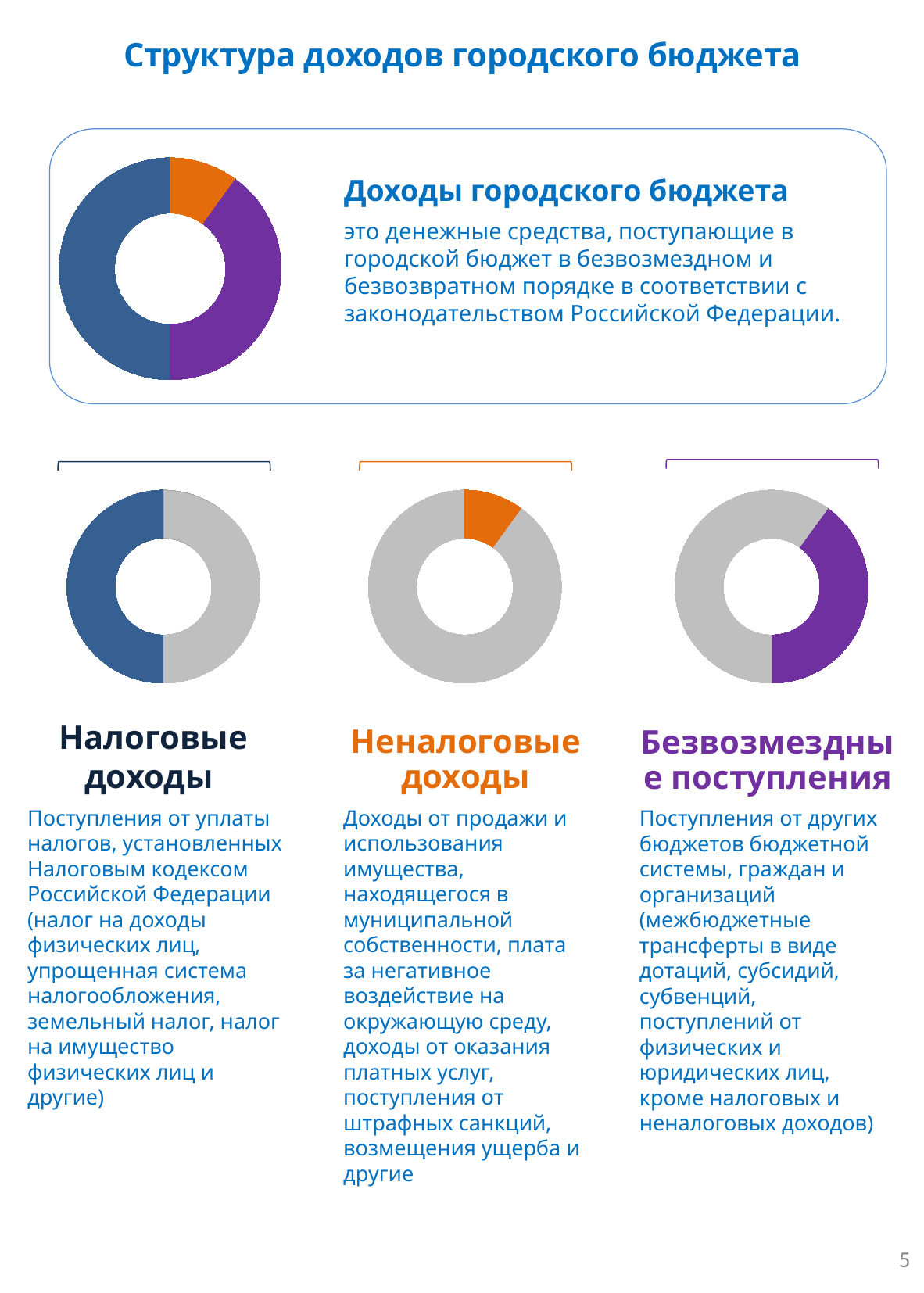
Comparing the bottom-middle chart (Неналоговые доходы) and the bottom-right chart (Безвозмездные поступления), which highlighted share is larger? Безвозмездные поступления Comparing the bottom-left chart (Налоговые доходы) and the bottom-middle chart (Неналоговые доходы), which highlighted share is larger? Налоговые доходы What kind of chart is the chart at the top of the slide, inside the rounded box? pie chart (donut) What is the title of the slide above the charts? Структура доходов городского бюджета How many donut charts are shown on the slide in total? 4 What colour is used for Неналоговые доходы in the charts on the slide? orange What kind of chart is the bottom-right chart labelled Безвозмездные поступления? pie chart (donut) How many slices does the top donut chart inside the rounded box have? 3 In the top donut chart inside the rounded box, which slice is the smallest? the orange slice (Неналоговые доходы) In the top donut chart inside the rounded box, which slice is the largest? the blue slice (Налоговые доходы)